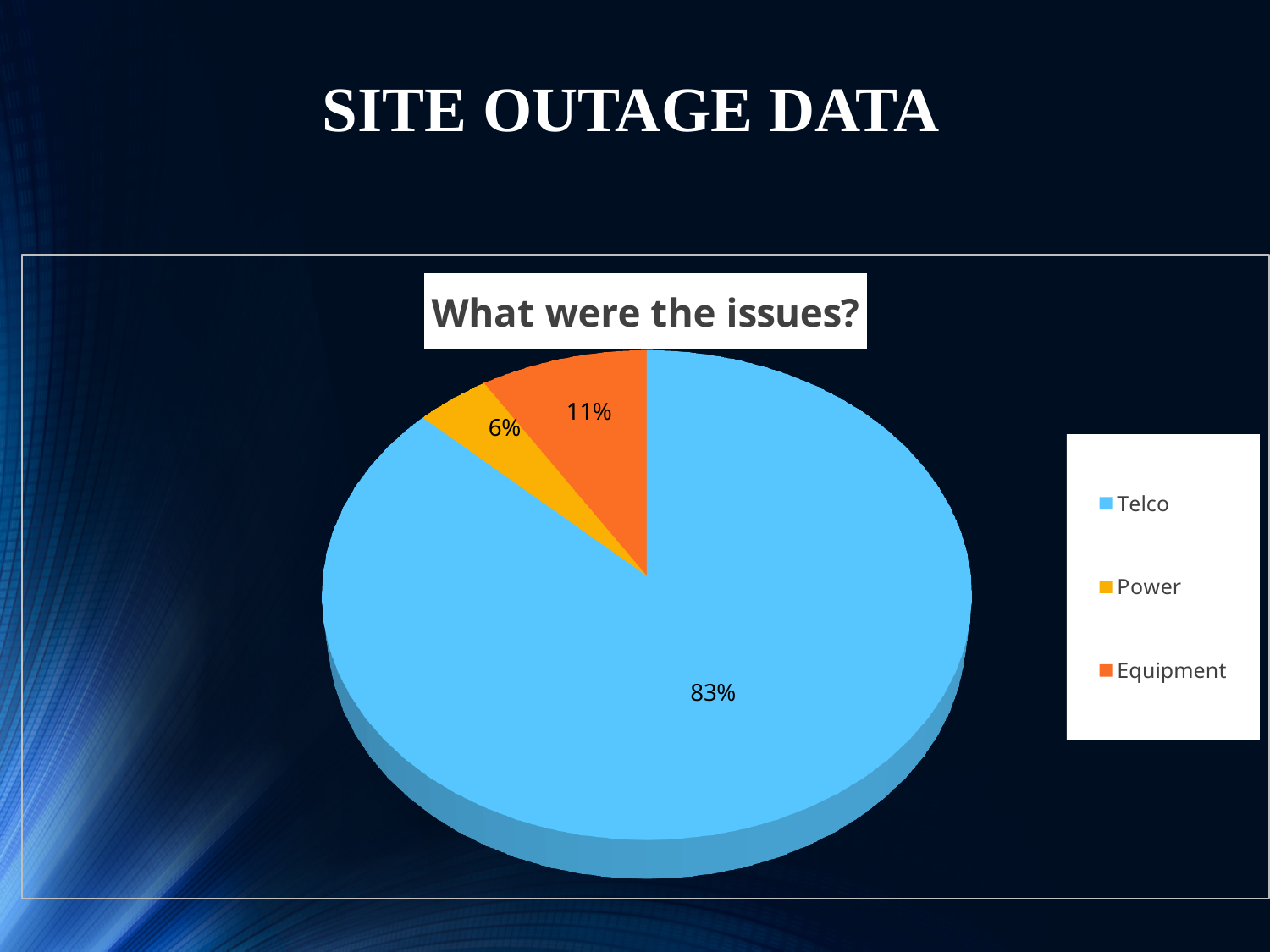
What kind of chart is shown on the slide? Pie chart What share of the pie does Equipment account for? 11% Which colour represents Power in the legend? Yellow What is the difference in percentage points between the Equipment and Power slices? 5 Which category has the largest slice of the pie? Telco What is the difference in percentage points between the Telco and Equipment slices? 72 What share of the pie does Telco account for? 83% Which category has the smallest slice of the pie? Power What share of the pie does Power account for? 6% What is the title of the chart? What were the issues? How many categories are shown in the pie chart? 3 Which slice is larger, Power or Equipment? Equipment